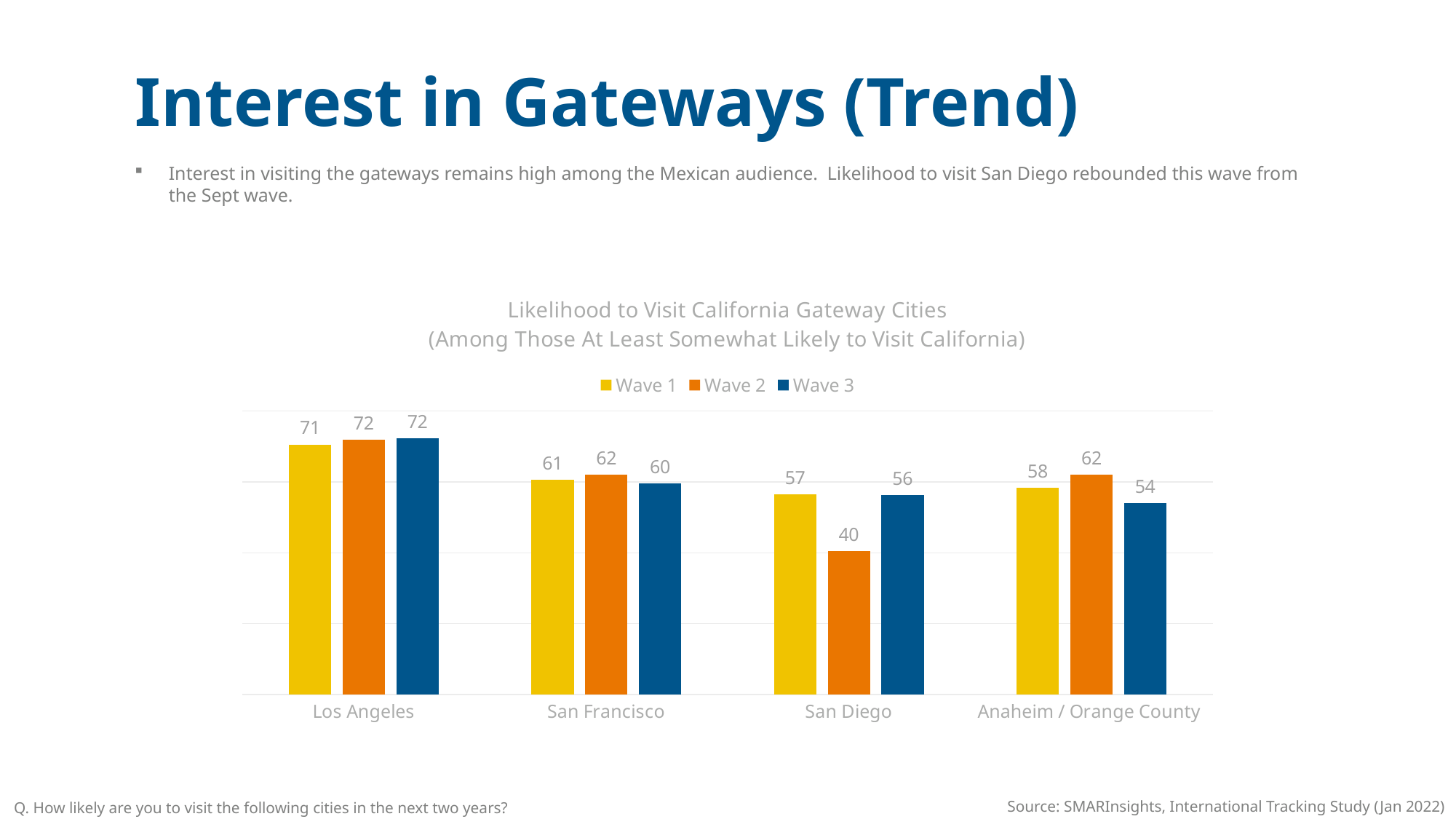
Do the Wave 1 values rise or fall from Los Angeles to San Diego? Fall How many cities are shown on the x axis? 4 Which series is shown in dark blue? Wave 3 What is the Wave 1 value for San Francisco? 61 Which city has the highest Wave 3 value? Los Angeles Which city has the lowest Wave 2 value? San Diego Which is larger for Anaheim / Orange County, the Wave 1 value or the Wave 3 value? Wave 1 What is the Wave 2 value for San Diego? 40 What kind of chart is shown? Bar chart What is the difference between the Wave 3 and Wave 2 values for San Diego? 16 How many series does the legend list? 3 What is the Wave 3 value for Anaheim / Orange County? 54